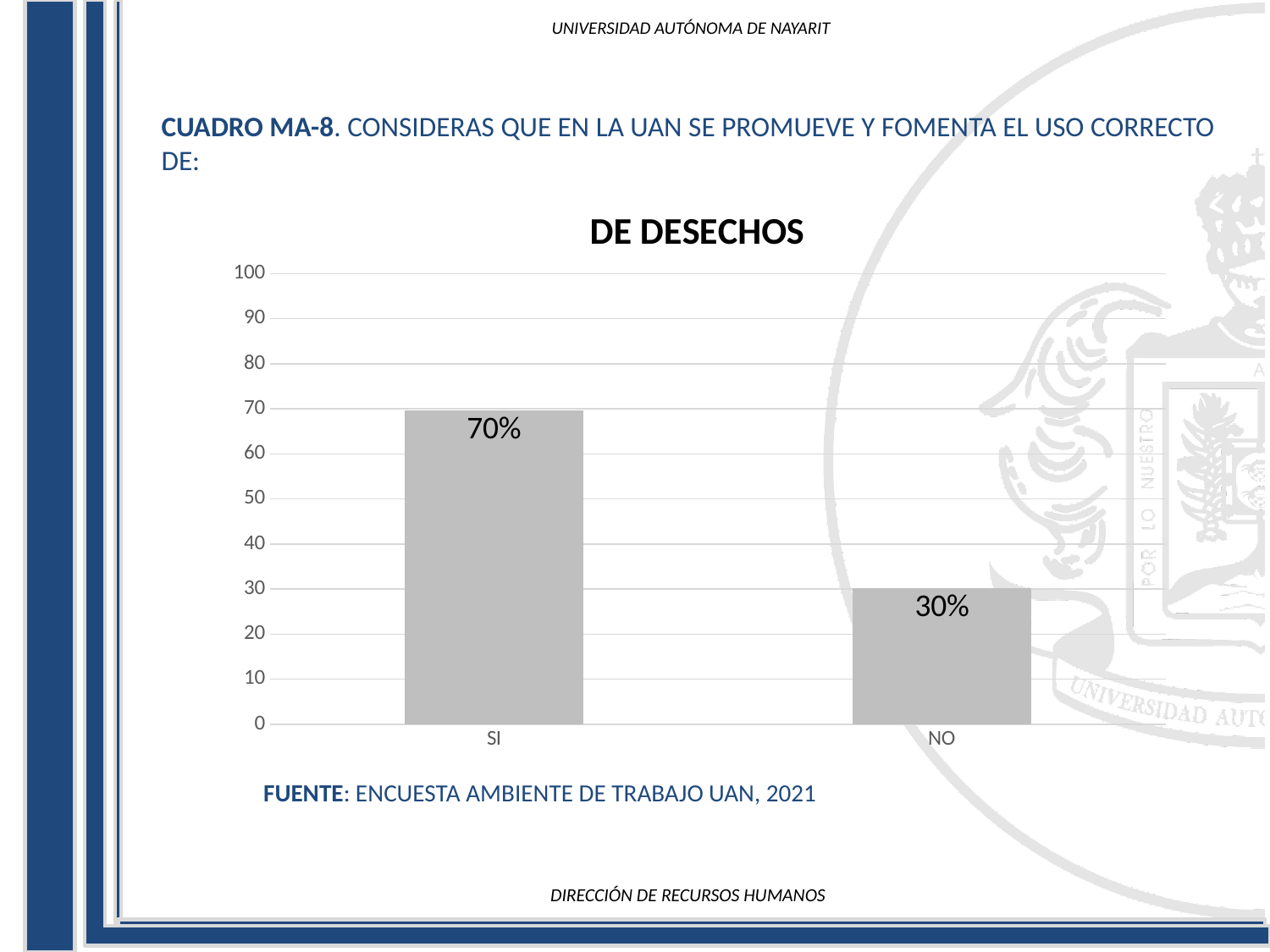
What is the title of the chart? DE DESECHOS What is the value for NO? 30% How many categories are shown on the x axis? 2 What is the difference between the values for SI and NO? 40% What is the maximum value shown on the y axis? 100 What kind of chart is shown? bar chart Is the value for SI greater or less than 50? greater Which category has the highest value? SI Is the value for NO greater or less than 40? less Which is larger, the value for SI or the value for NO? SI What is the value for SI? 70% Which category has the lowest value? NO